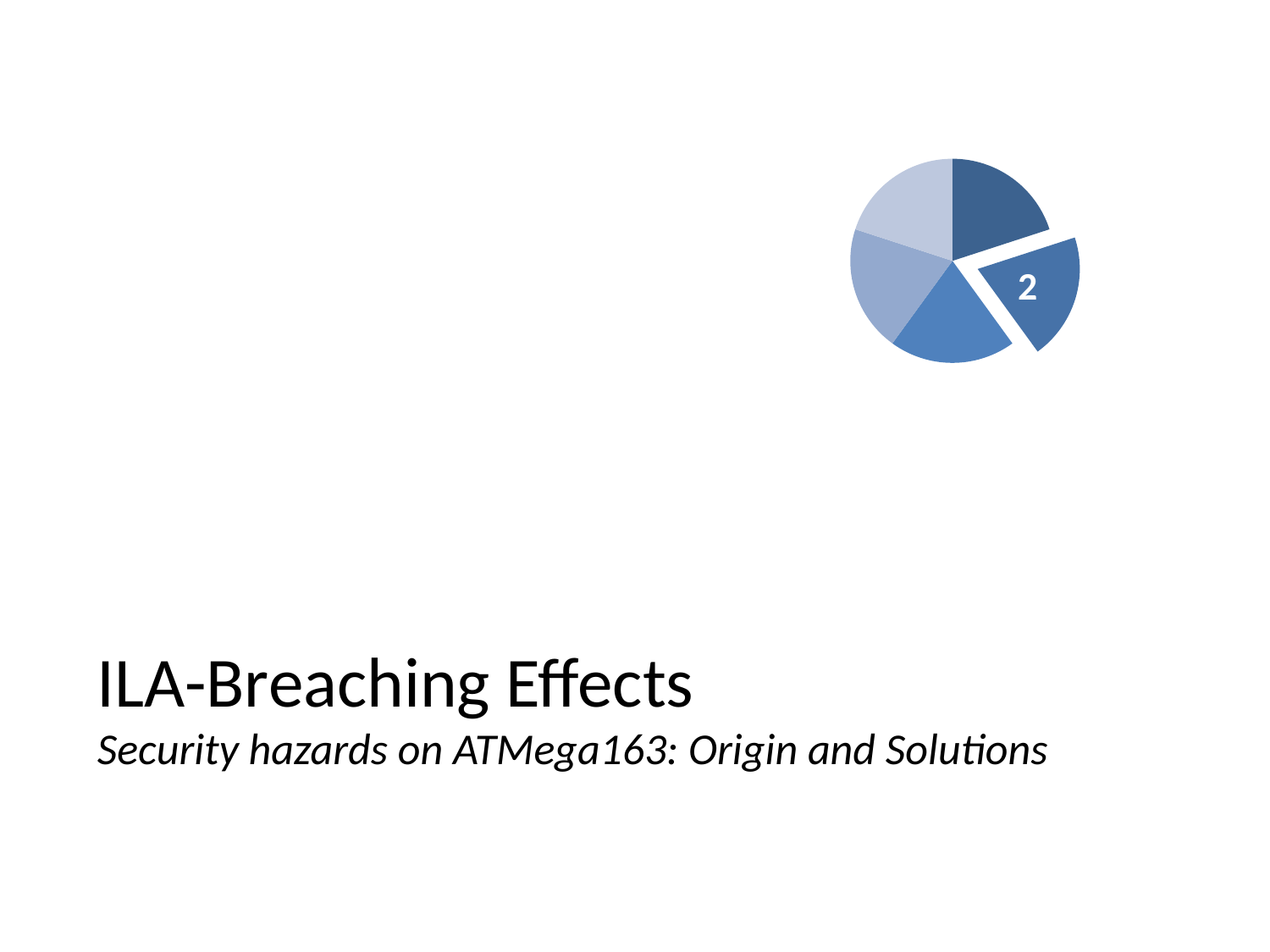
How many slices does the pie chart have? 5 How many slices of the pie chart are exploded (separated from the rest)? 1 What kind of chart is shown on the slide? pie chart Does the pie chart have a legend? No What label is printed on the slice that is pulled out from the pie chart? 2